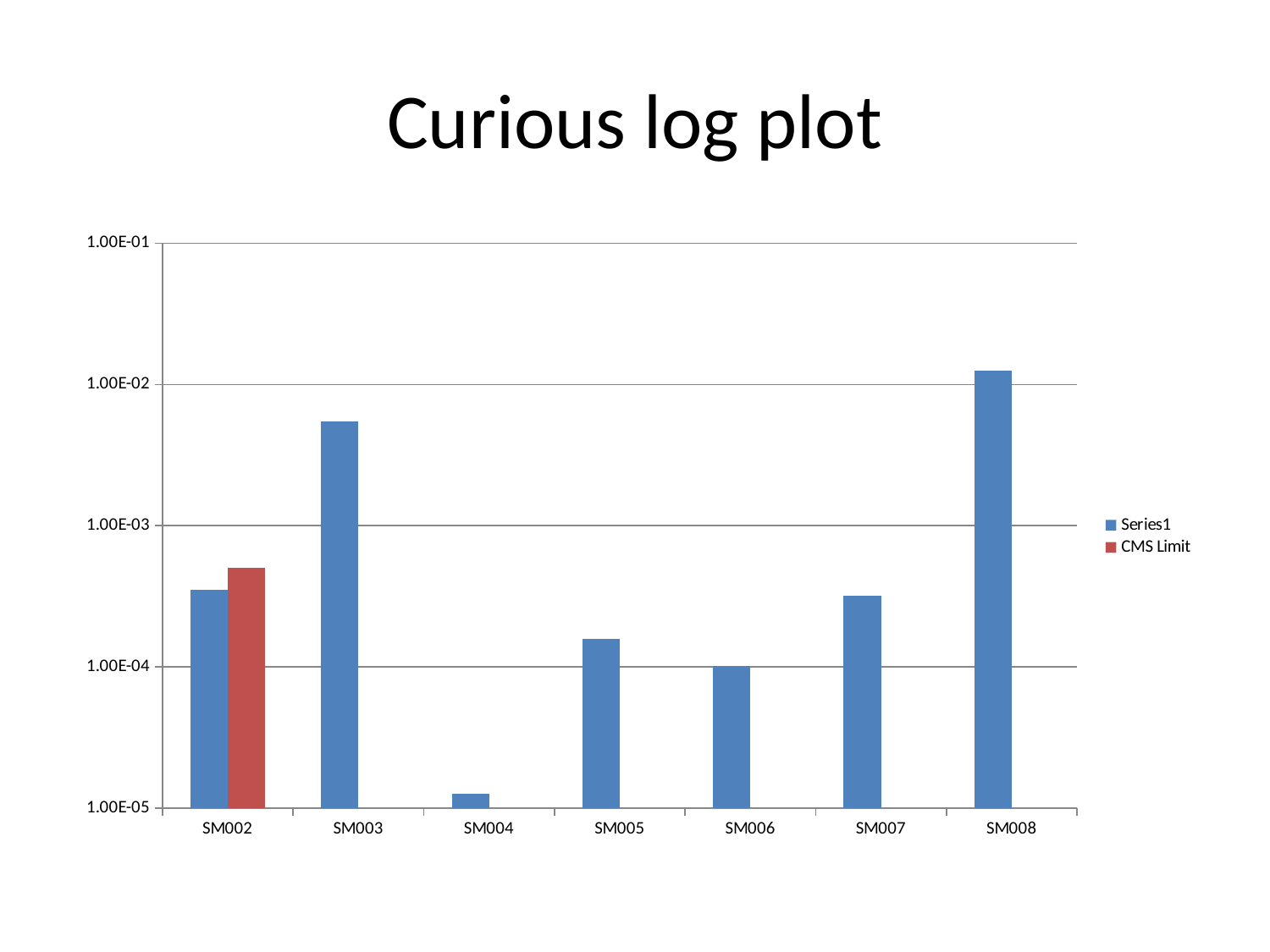
Is the Series1 value for SM002 greater or less than 1.00E-03? less Which is larger for SM002: the Series1 value or the CMS Limit value? CMS Limit How many series does the legend list? 2 How many categories are shown on the x axis? 7 Which category has the highest Series1 value? SM008 What is the title of the chart? Curious log plot Which category has the lowest Series1 value? SM004 Is the Series1 value for SM003 greater or less than 1.00E-03? greater Is the Series1 value for SM004 greater or less than 1.00E-04? less Which has the larger Series1 value, SM003 or SM007? SM003 What kind of chart is shown on the slide? bar chart